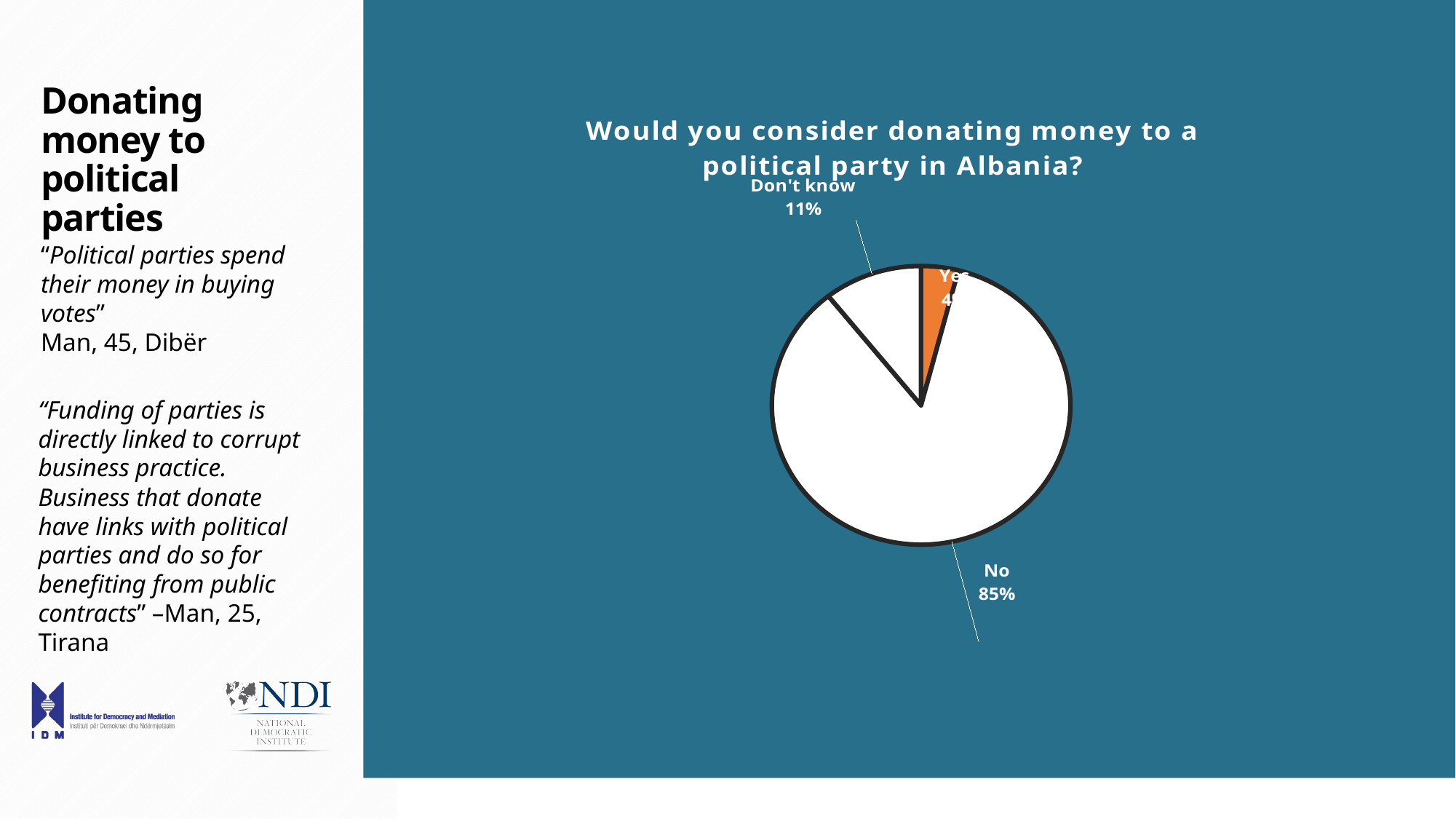
What share of the pie does the "No" slice represent? 85% What percentage of respondents answered "Don't know"? 11% Which is larger, the share for "Don't know" or the share for "Yes"? Don't know What kind of chart is shown on the slide? Pie chart What is the title of the chart? Would you consider donating money to a political party in Albania? How many slices does the pie chart have? 3 Which response has the largest share of the pie? No What percentage of respondents answered "No"? 85% What colour is the "Yes" slice of the pie? Orange What is the difference in percentage points between the "No" and "Don't know" responses? 74 percentage points Which response has the smallest share of the pie? Yes